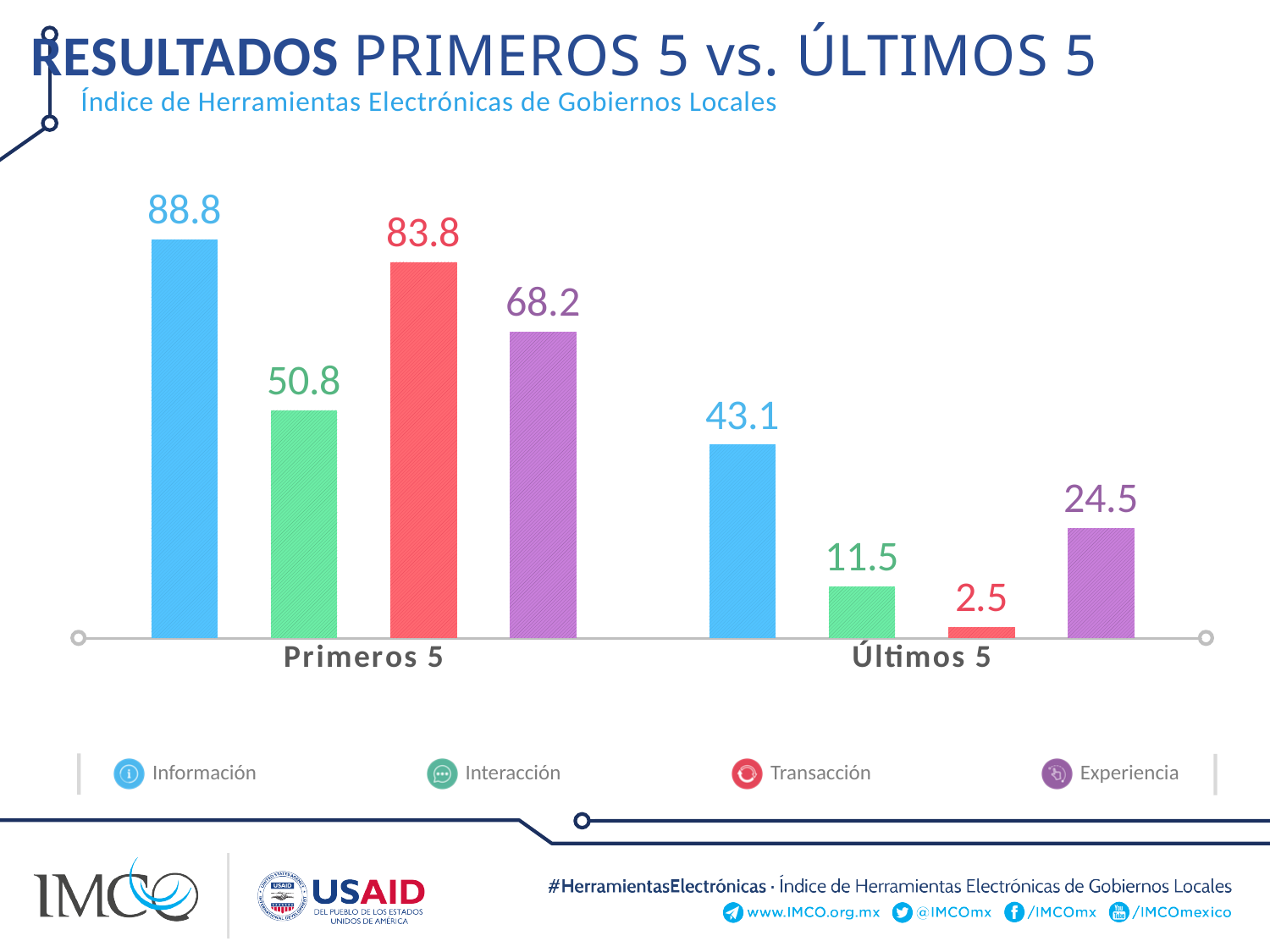
Which series has the lowest value in the Últimos 5 group? Transacción What is the value for Transacción in the Últimos 5 group? 2.5 How many series does the legend list? 4 What kind of chart is shown on the slide? Bar chart Which series has the highest value in the Primeros 5 group? Información Which is larger: Transacción for Primeros 5 or Experiencia for Primeros 5? Transacción for Primeros 5 How many categories are shown on the x axis? 2 What is the value for Información in the Primeros 5 group? 88.8 What colour are the Experiencia bars? Purple What is the value for Interacción in the Últimos 5 group? 11.5 What is the value for Experiencia in the Primeros 5 group? 68.2 What is the difference between the Información values for Primeros 5 and Últimos 5? 45.7